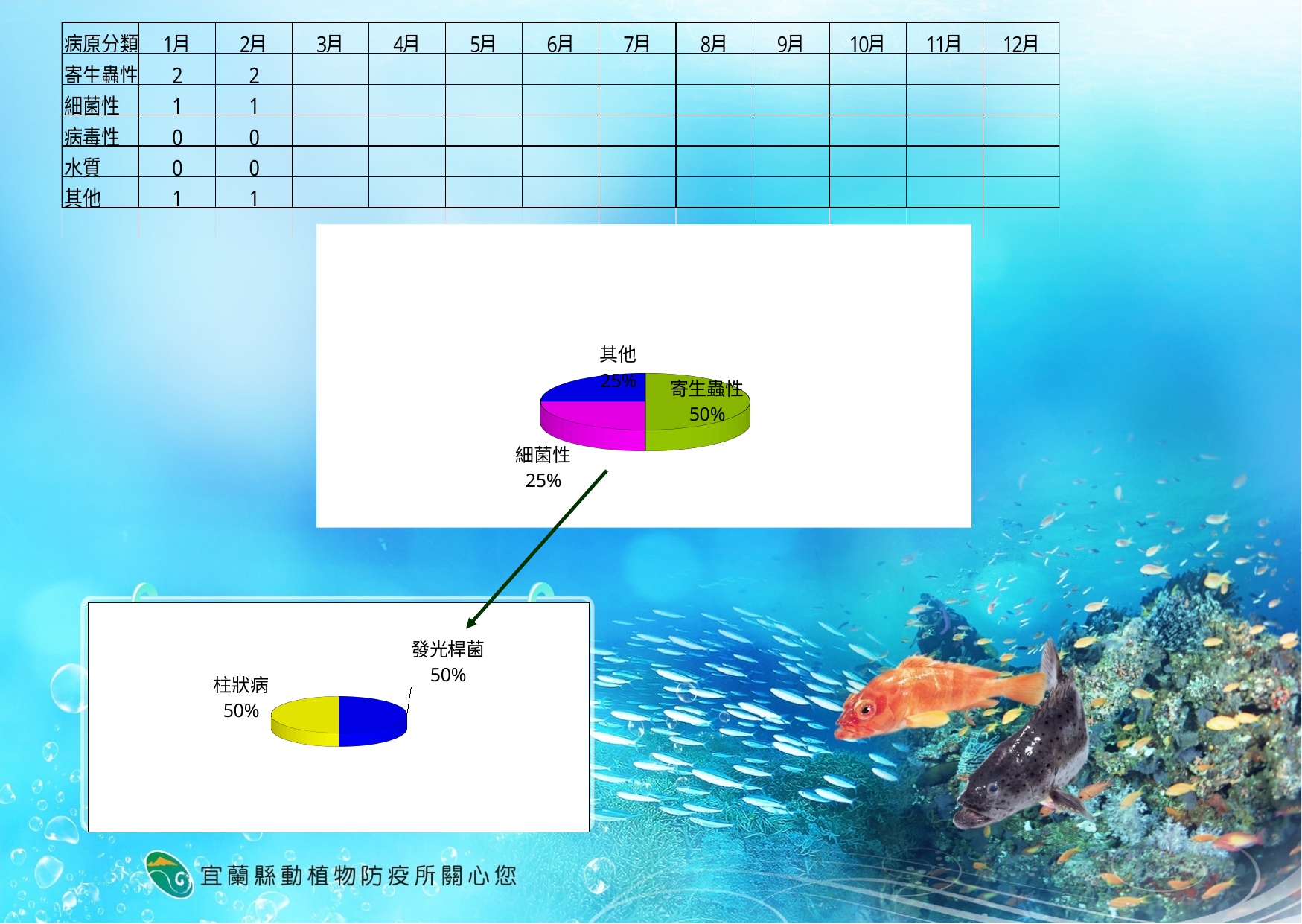
In the lower pie chart, what share does 發光桿菌 have? 50% In the upper pie chart, which category has the largest slice? 寄生蟲性 In the upper pie chart, what share does 其他 have? 25% In the upper pie chart, which is larger, 寄生蟲性 or 細菌性? 寄生蟲性 In the upper pie chart, what share does 寄生蟲性 have? 50% In the upper pie chart, how many slices are there? 3 In the lower pie chart, how many slices are there? 2 In the lower pie chart, what colour is the 柱狀病 slice? Yellow In the upper pie chart, what is the difference in share between 寄生蟲性 and 其他? 25% What kind of chart is the upper chart? Pie chart